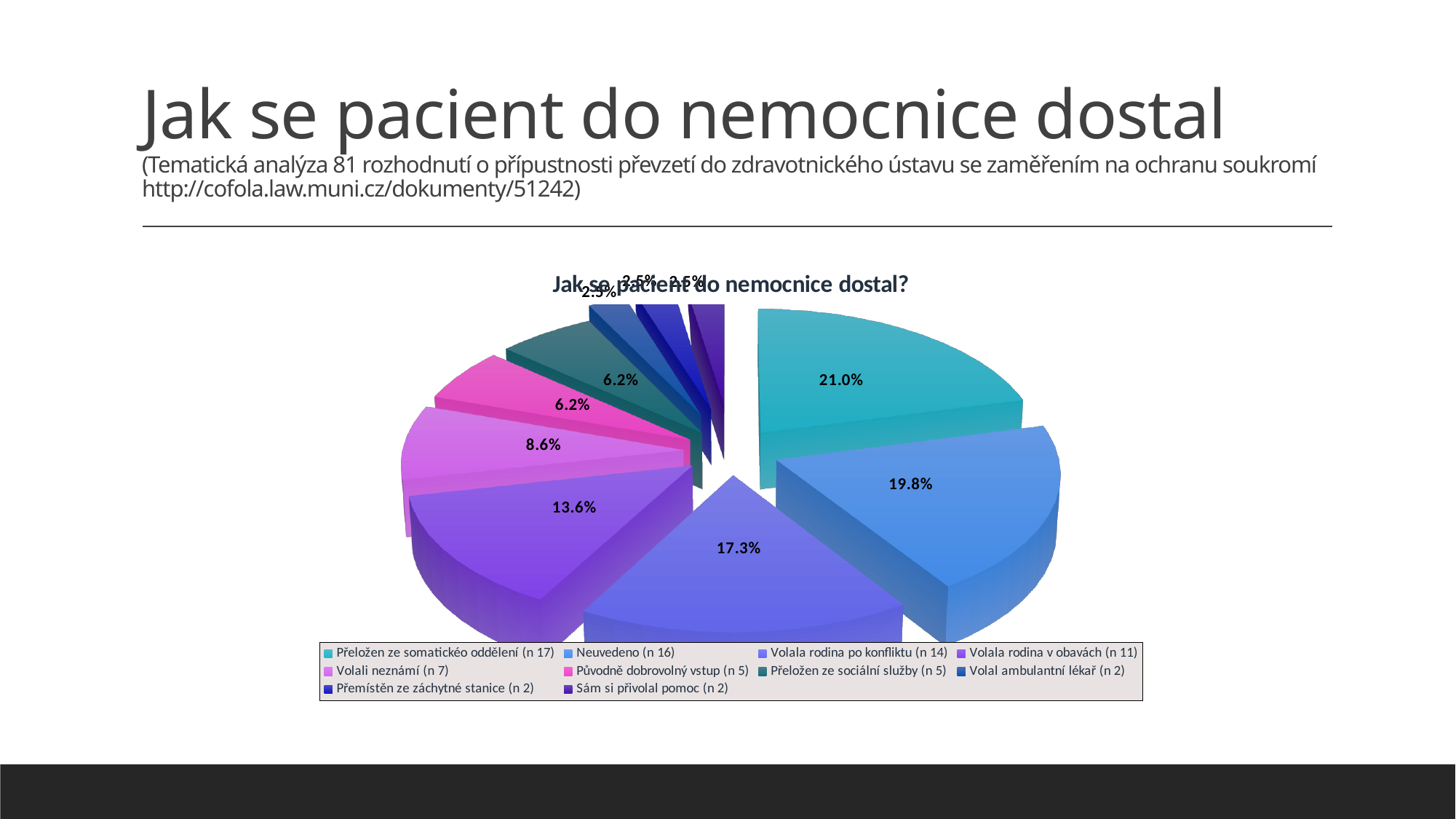
What is the difference in percentage points between "Přeložen ze somatickéo oddělení (n 17)" and "Neuvedeno (n 16)"? 1.2 What is the title of the chart? Jak se pacient do nemocnice dostal? What percentage is shown for "Volala rodina po konfliktu (n 14)"? 17.3% What percentage is shown for "Volali neznámí (n 7)"? 8.6% Which category has the largest share of the pie? Přeložen ze somatickéo oddělení (n 17) Which is larger, the share for "Volala rodina v obavách (n 11)" or for "Volali neznámí (n 7)"? Volala rodina v obavách (n 11) What percentage is shown for "Původně dobrovolný vstup (n 5)"? 6.2% What type of chart is shown on the slide? Pie chart How many categories does the legend list? 10 What percentage is shown for "Volala rodina v obavách (n 11)"? 13.6% What share of the pie does "Přeložen ze somatickéo oddělení (n 17)" represent? 21.0% What percentage is shown for "Neuvedeno (n 16)"? 19.8%